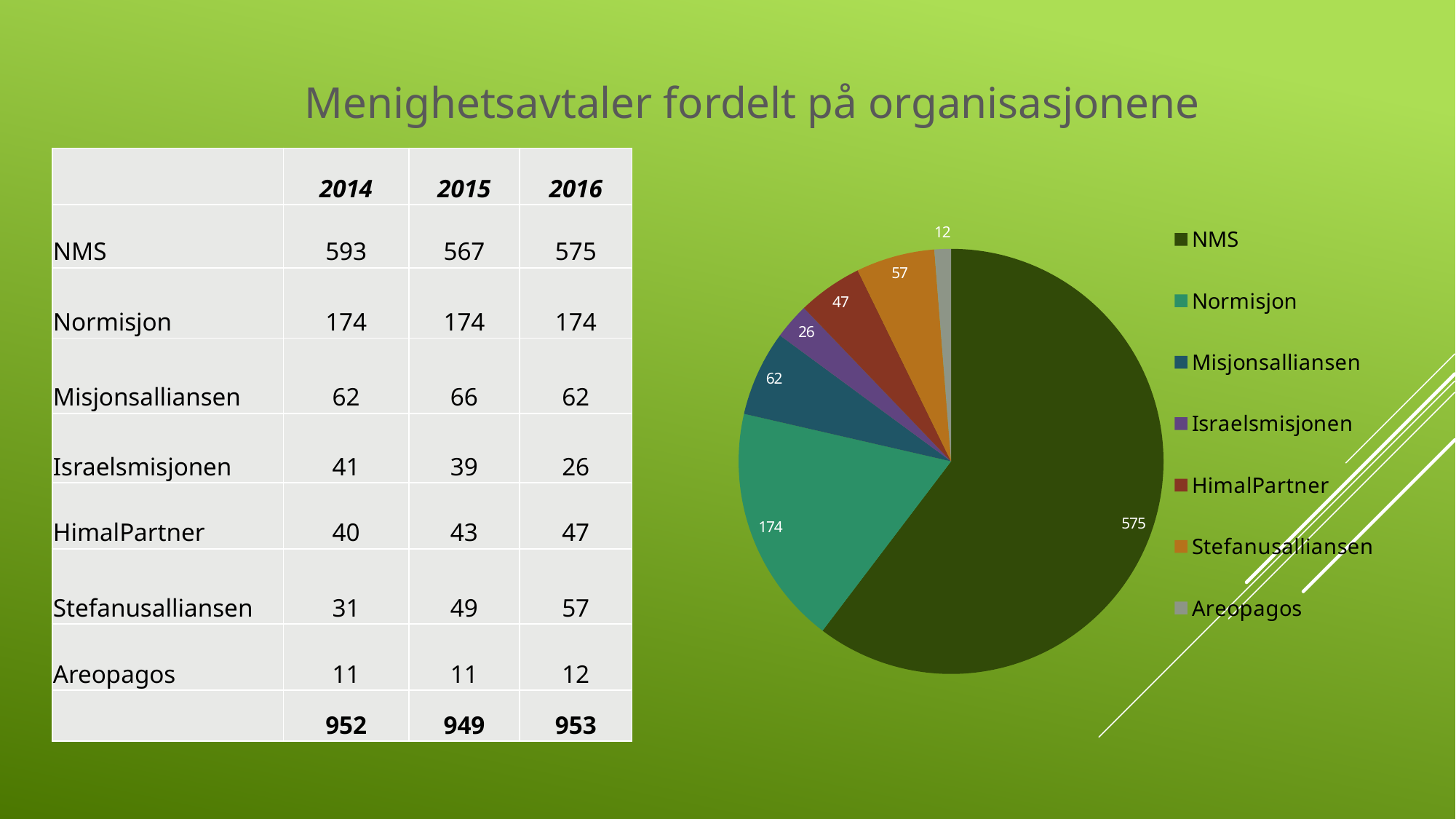
In the pie chart, what is the value for Normisjon? 174 What kind of chart is shown on the slide? pie chart In the pie chart, what is the value for Stefanusalliansen? 57 Which organisation has the smallest slice in the pie chart? Areopagos In the pie chart, what is the difference between the values for NMS and Normisjon? 401 How many slices does the pie chart have? 7 In the pie chart, what is the difference between the values for Misjonsalliansen and HimalPartner? 15 In the pie chart, which is larger: the value for Stefanusalliansen or the value for HimalPartner? Stefanusalliansen Which organisation has the largest slice in the pie chart? NMS In the pie chart, what is the value for NMS? 575 How many entries does the pie chart's legend list? 7 In the pie chart, what is the value for Israelsmisjonen? 26